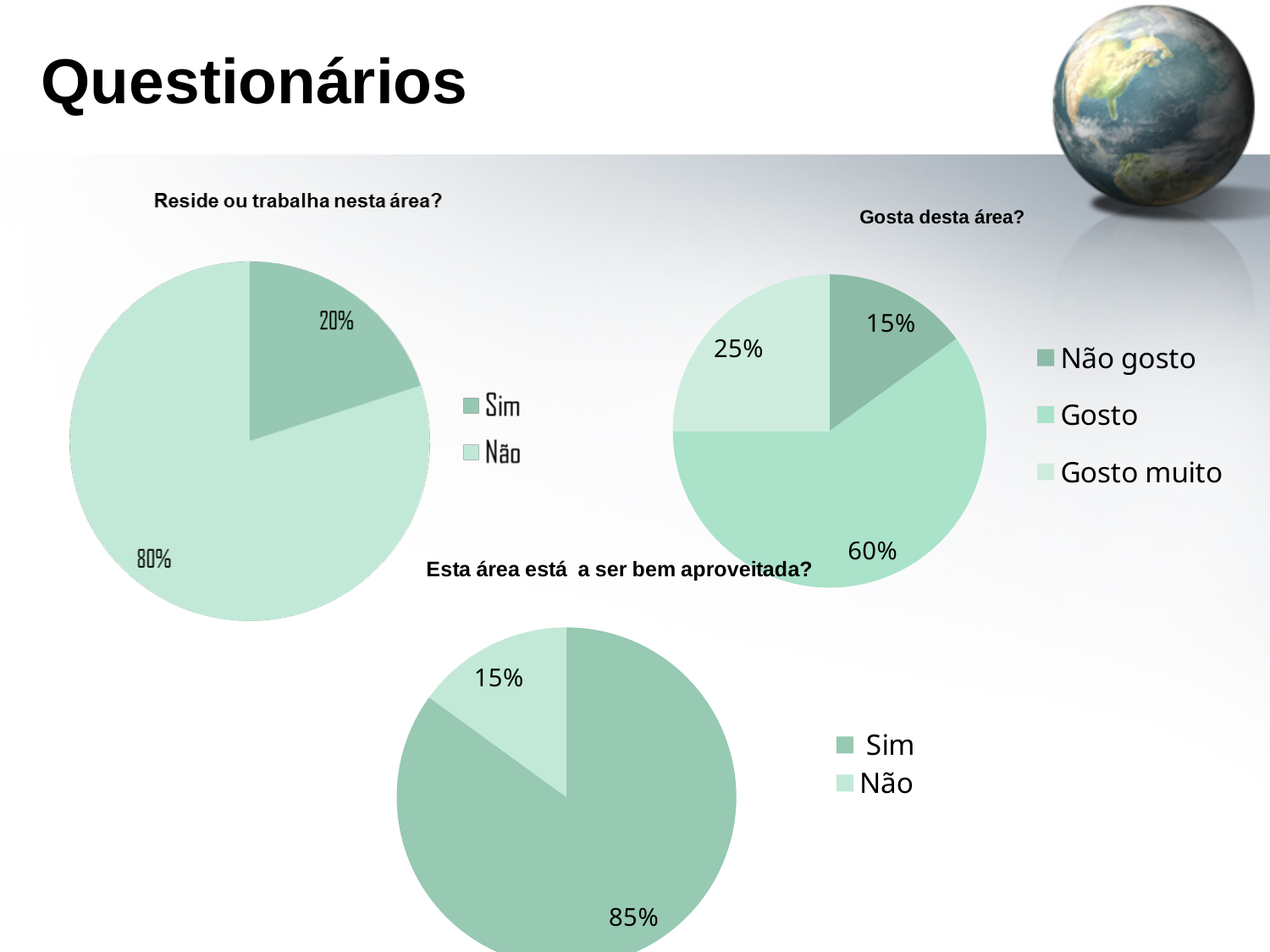
In the 'Gosta desta área?' chart, what percentage is shown for Não gosto? 15% How many categories does the legend of the 'Gosta desta área?' chart list? 3 In the 'Reside ou trabalha nesta área?' chart, what percentage is shown for Sim? 20% In the 'Gosta desta área?' chart, what percentage is shown for Gosto muito? 25% In the 'Reside ou trabalha nesta área?' chart, what percentage is shown for Não? 80% In the 'Reside ou trabalha nesta área?' chart, which is larger, Sim or Não? Não In the 'Gosta desta área?' chart, which category has the largest share? Gosto In the 'Esta área está a ser bem aproveitada?' chart, what percentage is shown for Sim? 85% In the 'Esta área está a ser bem aproveitada?' chart, what is the difference between the Sim and Não shares? 70% What type of chart is the 'Esta área está a ser bem aproveitada?' chart? Pie chart In the 'Gosta desta área?' chart, which category has the smallest share? Não gosto In the 'Gosta desta área?' chart, what percentage is shown for Gosto? 60%